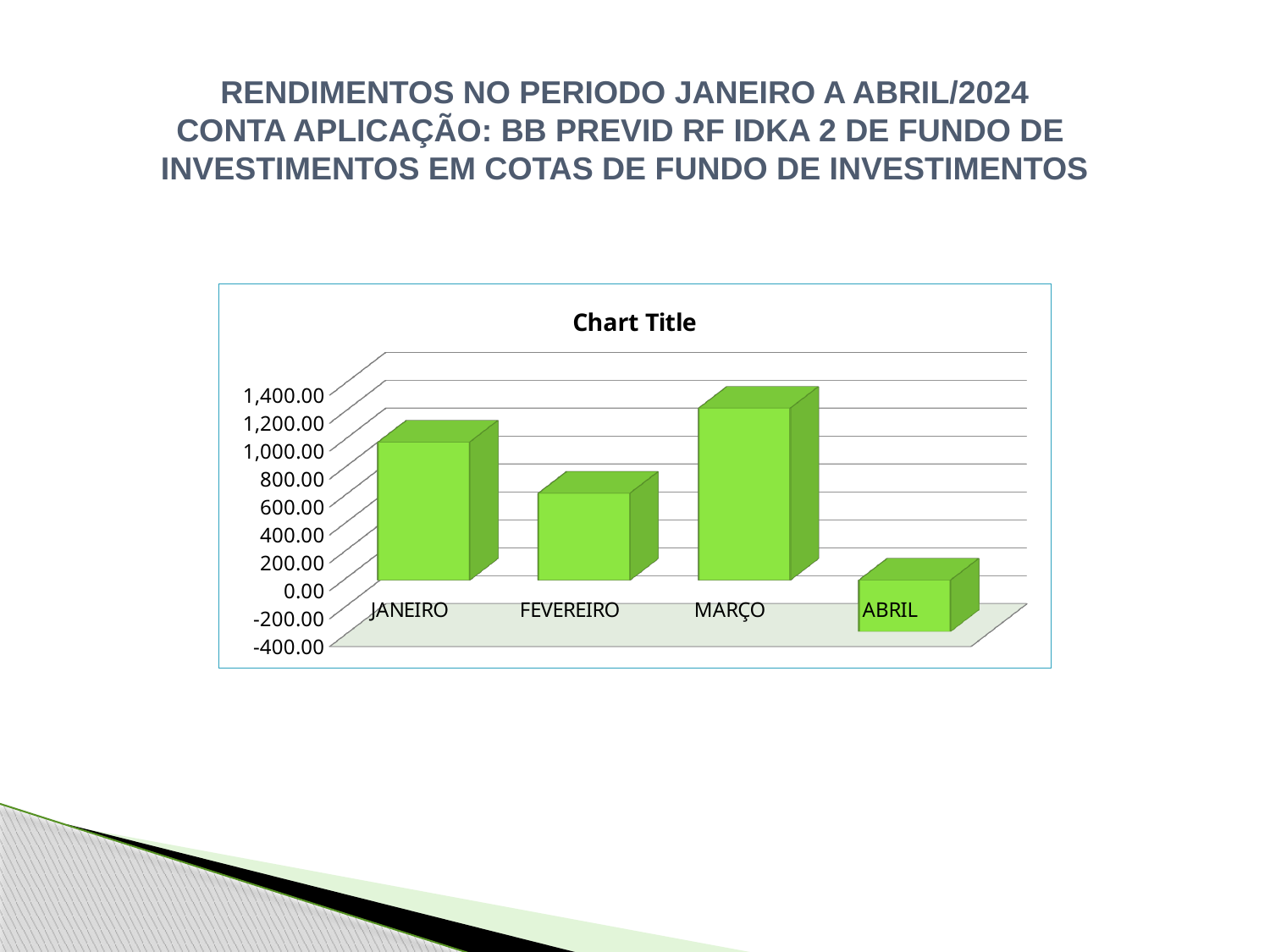
Which is larger, the value for MARÇO or the value for JANEIRO? MARÇO Which month has the highest value in the chart? MARÇO Which is larger, the value for JANEIRO or the value for FEVEREIRO? JANEIRO How many categories are plotted on the x axis of the chart? 4 What kind of chart is shown on the slide? bar chart Is the value for ABRIL greater or less than 0.00? less Is the value for JANEIRO greater or less than 800.00? greater Which month has the lowest value in the chart? ABRIL What title is printed above the chart's plot area? Chart Title Is the value for MARÇO greater or less than 1,000.00? greater Does the value rise or fall from MARÇO to ABRIL? fall